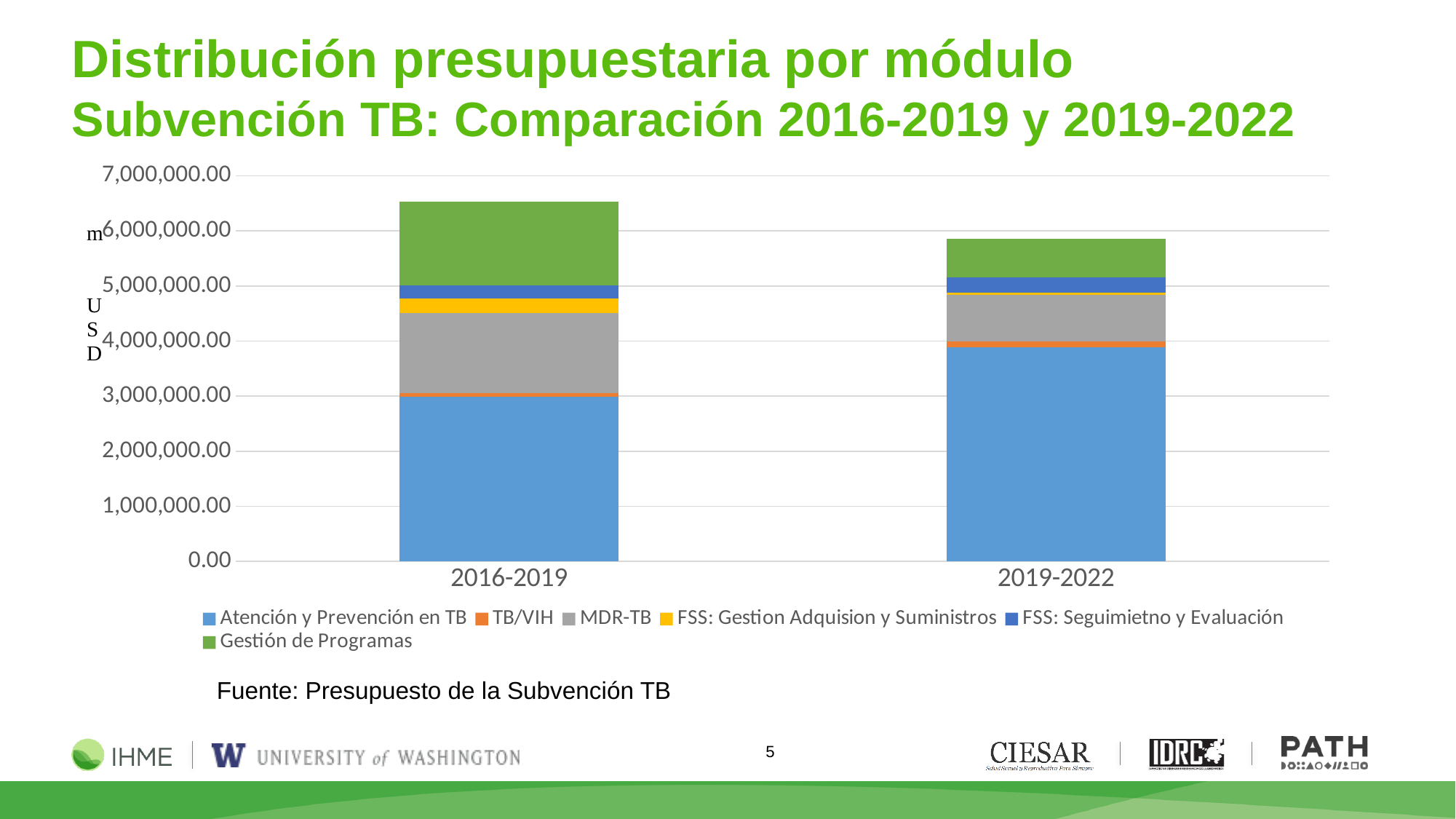
How many series does the legend list? 6 Is the value for Atención y Prevención en TB in 2019-2022 greater or less than 3,000,000.00? greater What unit is shown on the vertical axis label? USD Is the total for 2016-2019 greater or less than 6,000,000.00? greater How many periods (categories) are shown on the x axis? 2 Which series is shown in green at the top of each bar? Gestión de Programas Which period has the lowest total budget? 2019-2022 Which period has the taller total bar, 2016-2019 or 2019-2022? 2016-2019 What kind of chart is shown on the slide? Stacked bar chart Does the total budget rise or fall from 2016-2019 to 2019-2022? Fall Is the total for 2019-2022 greater or less than 6,000,000.00? less